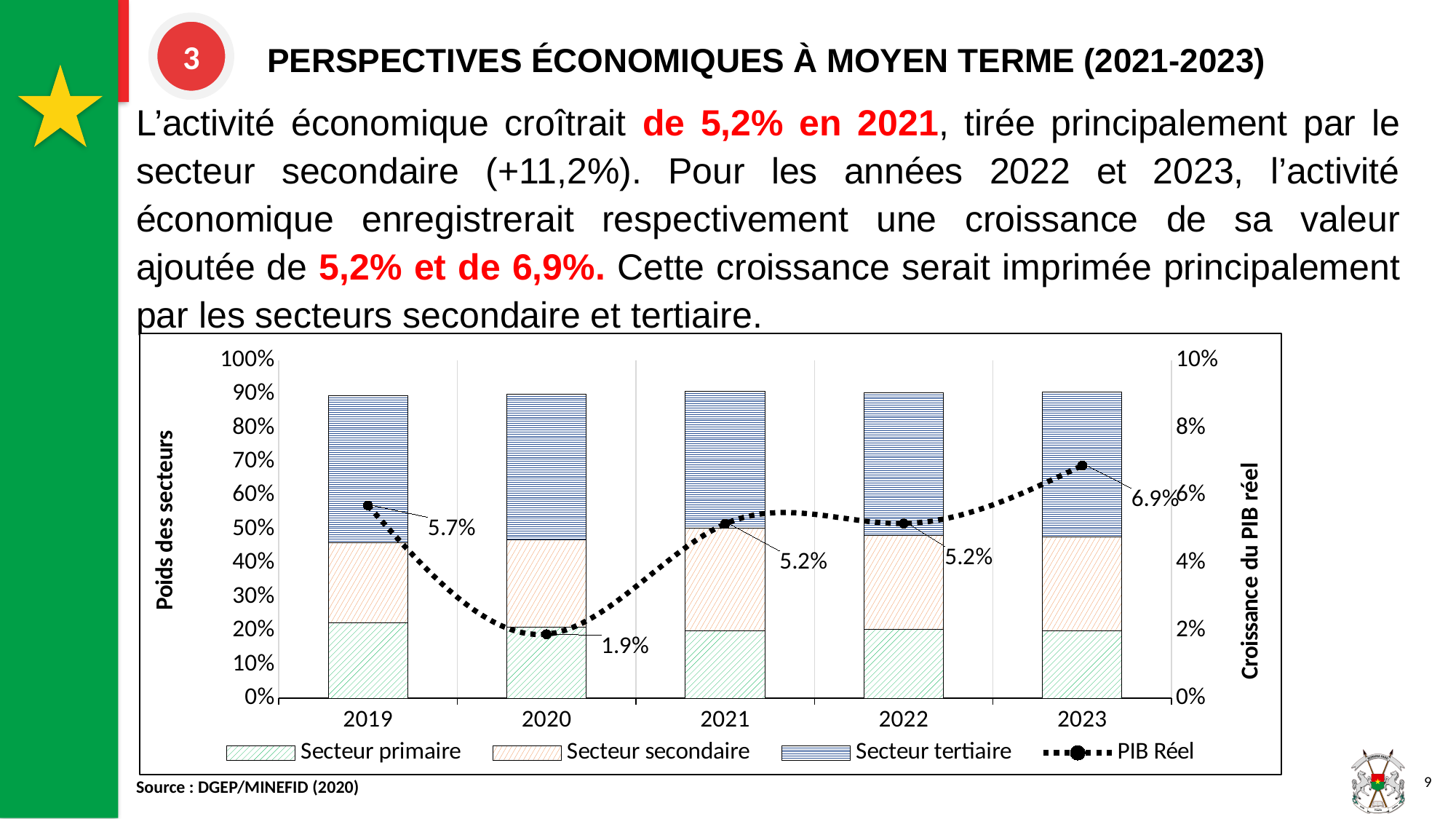
What is the PIB Réel growth value shown for 2019? 5.7% What is the difference between the PIB Réel growth in 2023 and in 2020? 5.0% Does the PIB Réel line rise or fall from 2020 to 2023? rise Which year has a higher PIB Réel growth, 2019 or 2022? 2019 What is the PIB Réel growth value shown for 2020? 1.9% What kind of chart is shown on the slide? Combined stacked bar and line chart How many years are shown on the x axis of the chart? 5 In which year is the PIB Réel growth highest? 2023 In which year is the PIB Réel growth lowest? 2020 Is the value for Secteur primaire in 2019 greater or less than 30%? less How many series does the chart legend list? 4 What is the PIB Réel growth value shown for 2021? 5.2%